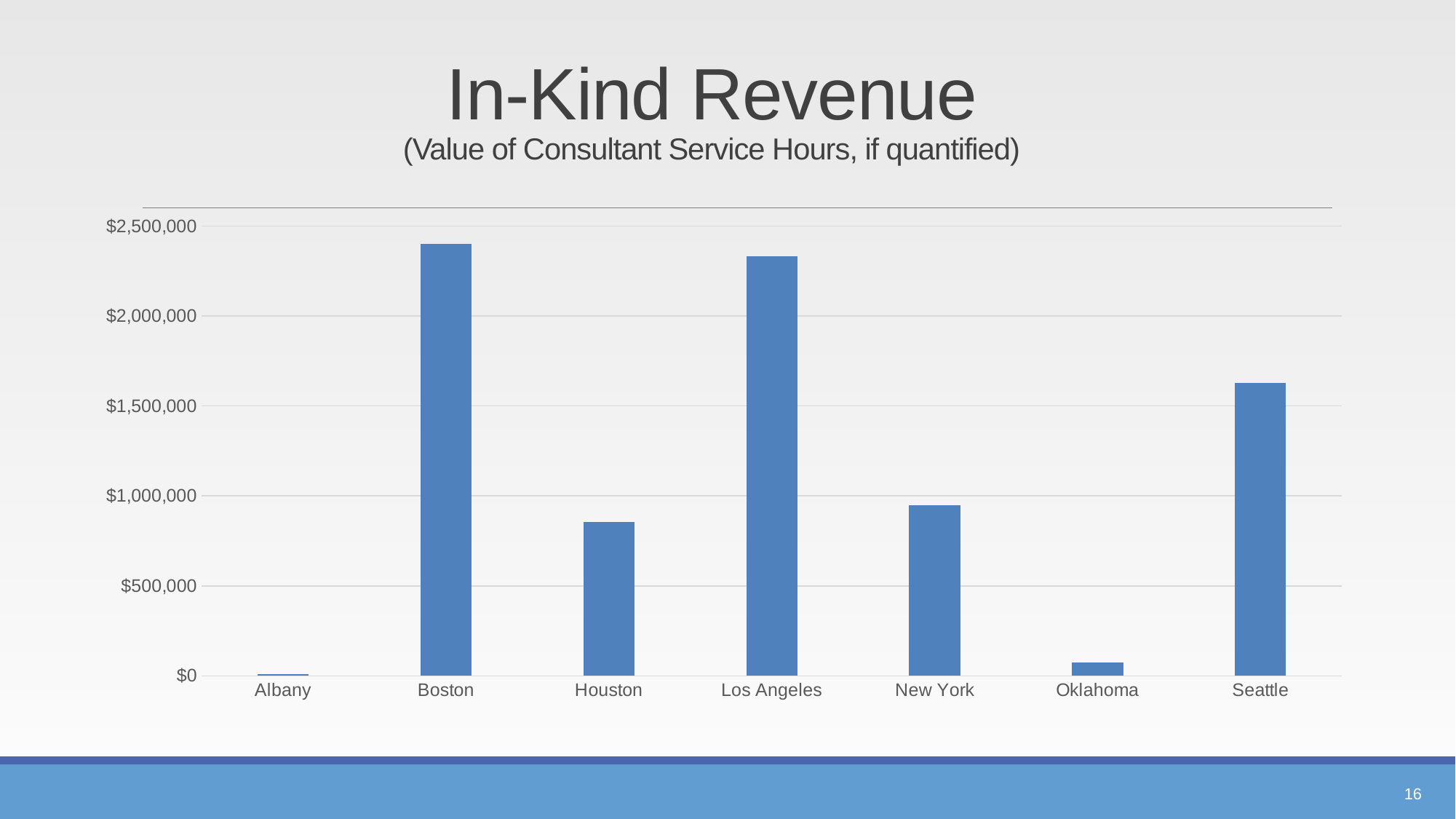
What is the subtitle shown under the chart title? (Value of Consultant Service Hours, if quantified) What kind of chart is shown on the slide? bar chart Is the value for Houston greater or less than $1,000,000? less What is the title of the chart on the slide? In-Kind Revenue Is the value for Seattle greater or less than $1,500,000? greater Is the value for Boston greater or less than $2,000,000? greater Which has the larger in-kind revenue, Houston or Oklahoma? Houston Which city has the lowest in-kind revenue? Albany How many cities are shown on the x axis of the chart? 7 Which has the larger in-kind revenue, Seattle or New York? Seattle